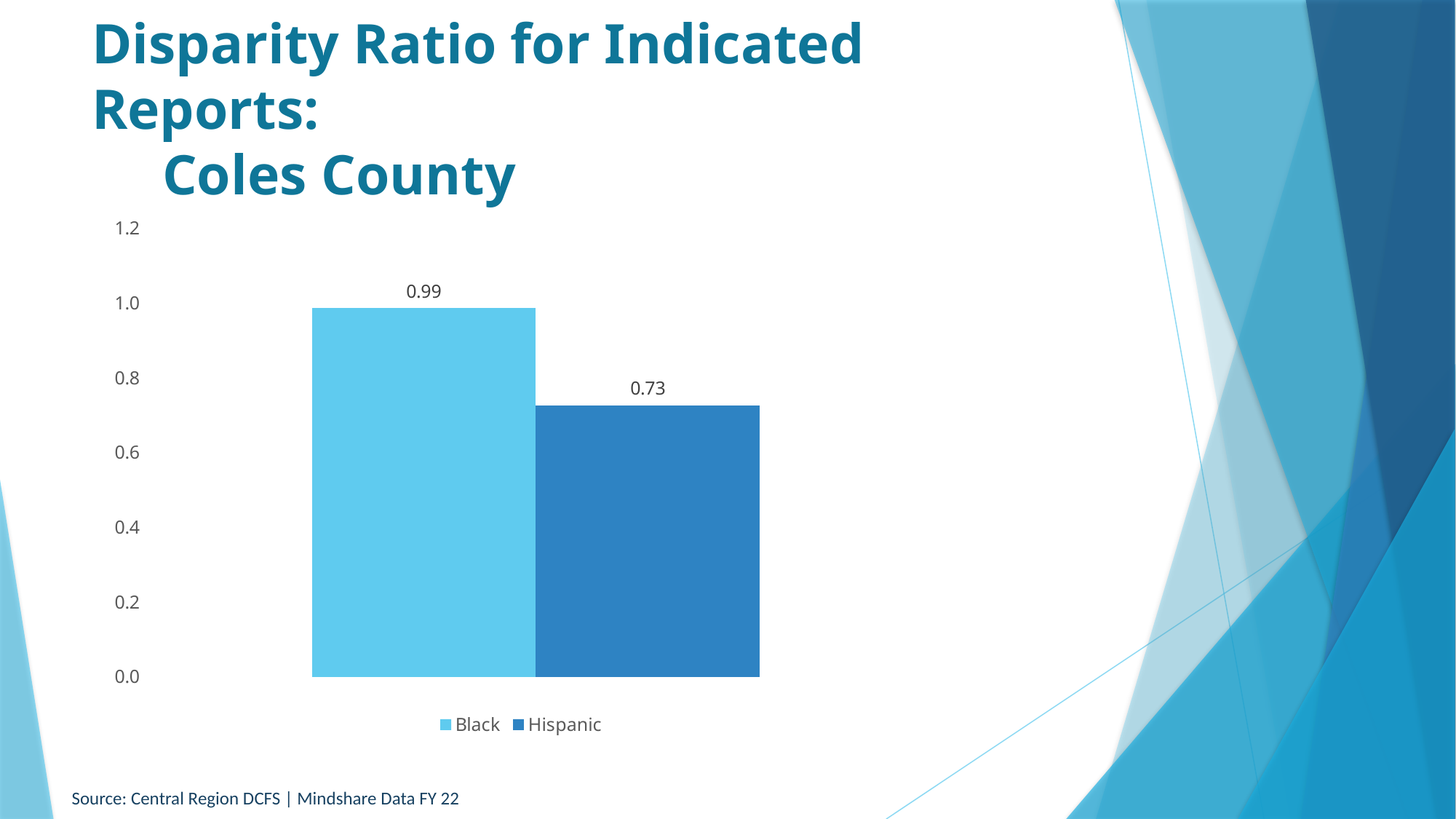
What is the disparity ratio for Black in the chart? 0.99 Is the disparity ratio for Hispanic greater or less than 0.8? less What kind of chart is shown on the slide? bar chart Which county does the chart title refer to? Coles County What is the maximum value shown on the vertical axis? 1.2 What is the difference between the disparity ratios for Black and Hispanic? 0.26 Is the value for Hispanic larger or smaller than the value for Black? smaller How many series does the legend list? 2 What is the disparity ratio for Hispanic in the chart? 0.73 Which group has the higher disparity ratio? Black Which group has the lower disparity ratio? Hispanic Is the disparity ratio for Black greater or less than 1.0? less